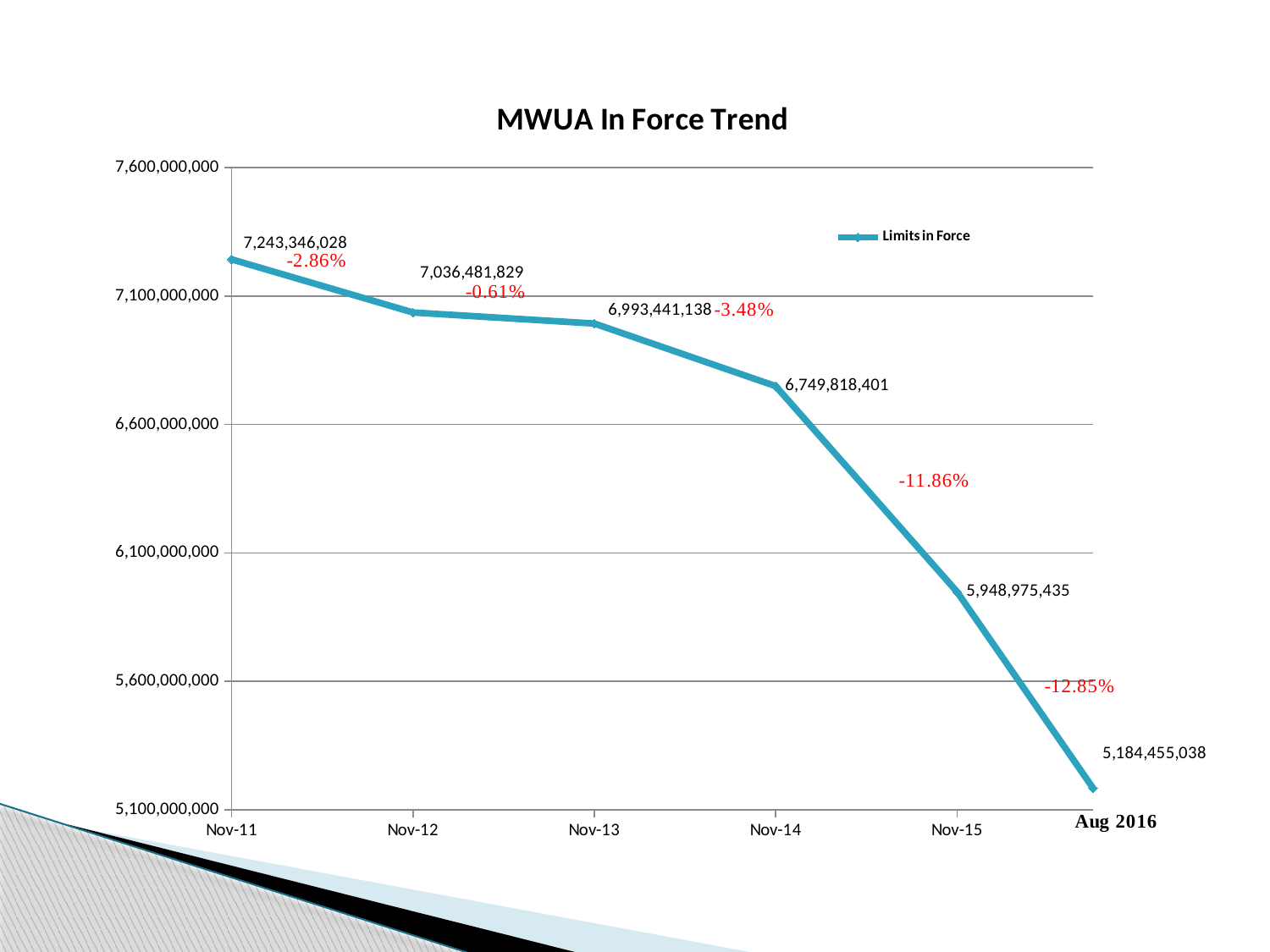
What is the value of Limits in Force for Nov-11? 7,243,346,028 Which point on the x axis has the highest Limits in Force? Nov-11 Which point on the x axis has the lowest Limits in Force? Aug 2016 What is the title of the chart? MWUA In Force Trend What is the difference in Limits in Force between Nov-11 and Nov-12? 206,864,199 What is the value of Limits in Force for Nov-14? 6,749,818,401 What is the value of Limits in Force for Aug 2016? 5,184,455,038 What is the difference in Limits in Force between Nov-15 and Aug 2016? 764,520,397 What kind of chart is shown on the slide? Line chart Which is larger, the Limits in Force for Nov-13 or for Nov-15? Nov-13 How many data points are plotted on the line? 6 Do the Limits in Force values rise or fall from Nov-11 to Aug 2016? Fall